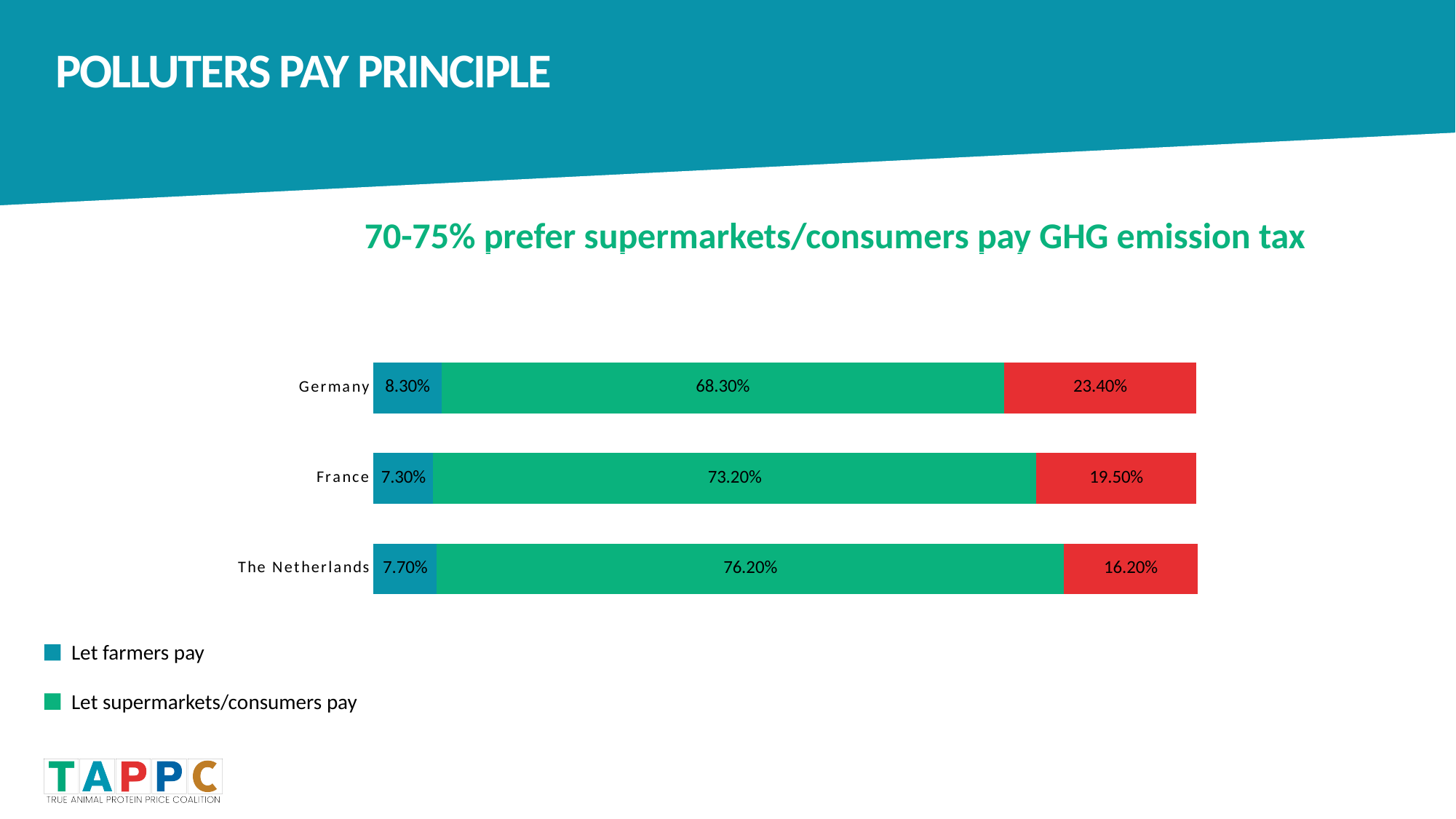
Which is larger: the 'Let farmers pay' value for Germany or for The Netherlands? Germany How many countries are shown in the chart? 3 Which country has the highest value for 'Let supermarkets/consumers pay'? The Netherlands What is the value for 'Let supermarkets/consumers pay' for The Netherlands? 76.20% What is the difference between the 'Let supermarkets/consumers pay' values for The Netherlands and Germany? 7.90% What is the value for 'Let farmers pay' for France? 7.30% How many series does the legend list? 2 What kind of chart is shown on the slide? Stacked bar chart Which country has the lowest value for 'Let farmers pay'? France What is the title of the chart? 70-75% prefer supermarkets/consumers pay GHG emission tax What is the value of the red segment for Germany? 23.40% What is the value for 'Let supermarkets/consumers pay' for Germany? 68.30%